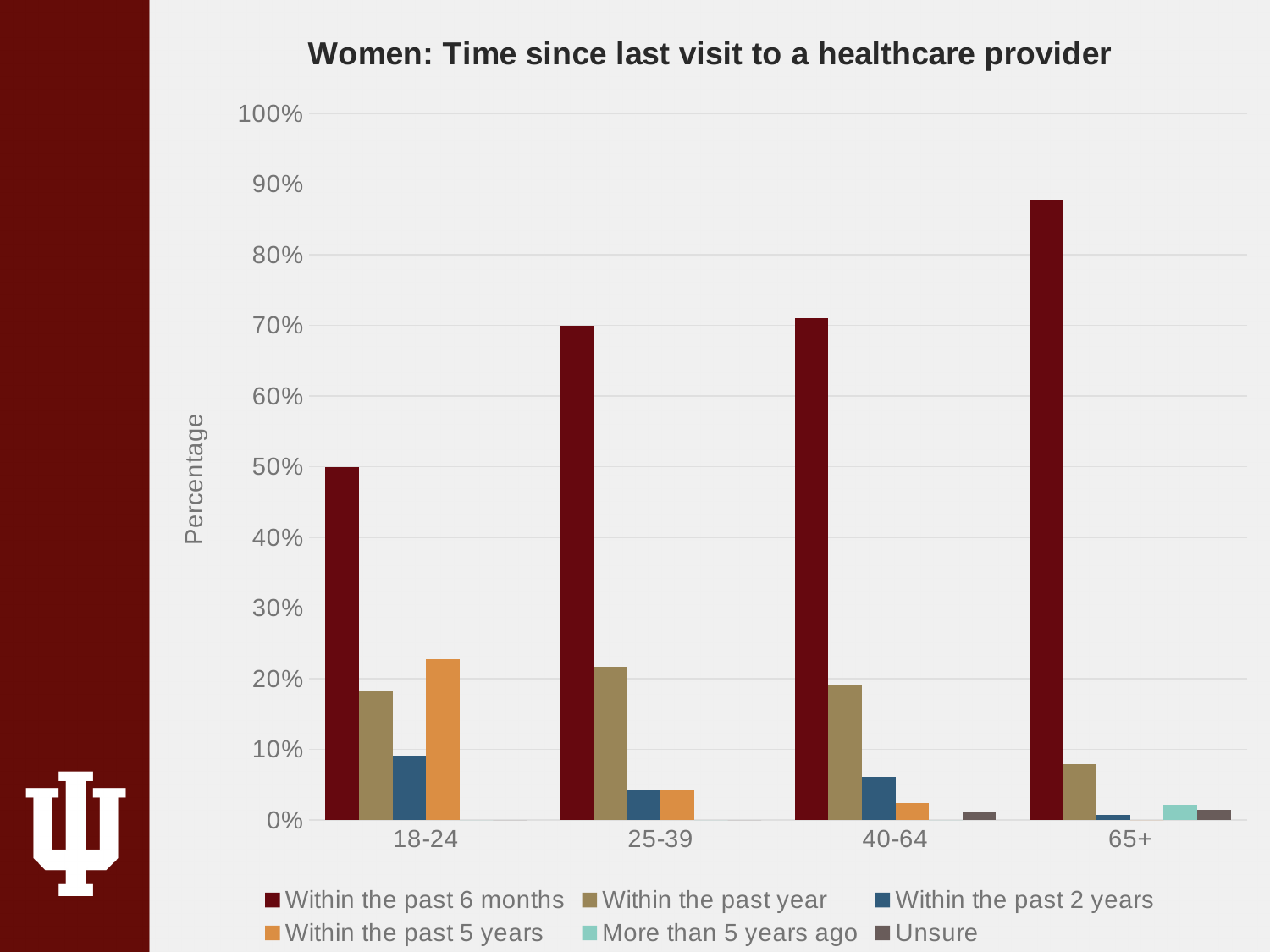
Is the value for 'Within the past year' in the 25-39 group greater or less than 30%? less In the 18-24 group, which is larger: 'Within the past 5 years' or 'Within the past year'? Within the past 5 years Which age group has the highest value for 'Within the past 6 months'? 65+ How many age groups are shown on the x axis? 4 What is the title of the chart? Women: Time since last visit to a healthcare provider Is the value for 'Within the past 6 months' in the 65+ group greater or less than 80%? greater Does the value for 'Within the past 6 months' rise or fall as the age groups go from 18-24 to 65+? rise Is the value for 'Within the past 5 years' in the 18-24 group greater or less than 20%? greater Which age group has the lowest value for 'Within the past 6 months'? 18-24 What type of chart is shown on the slide? Bar chart How many series does the legend list? 6